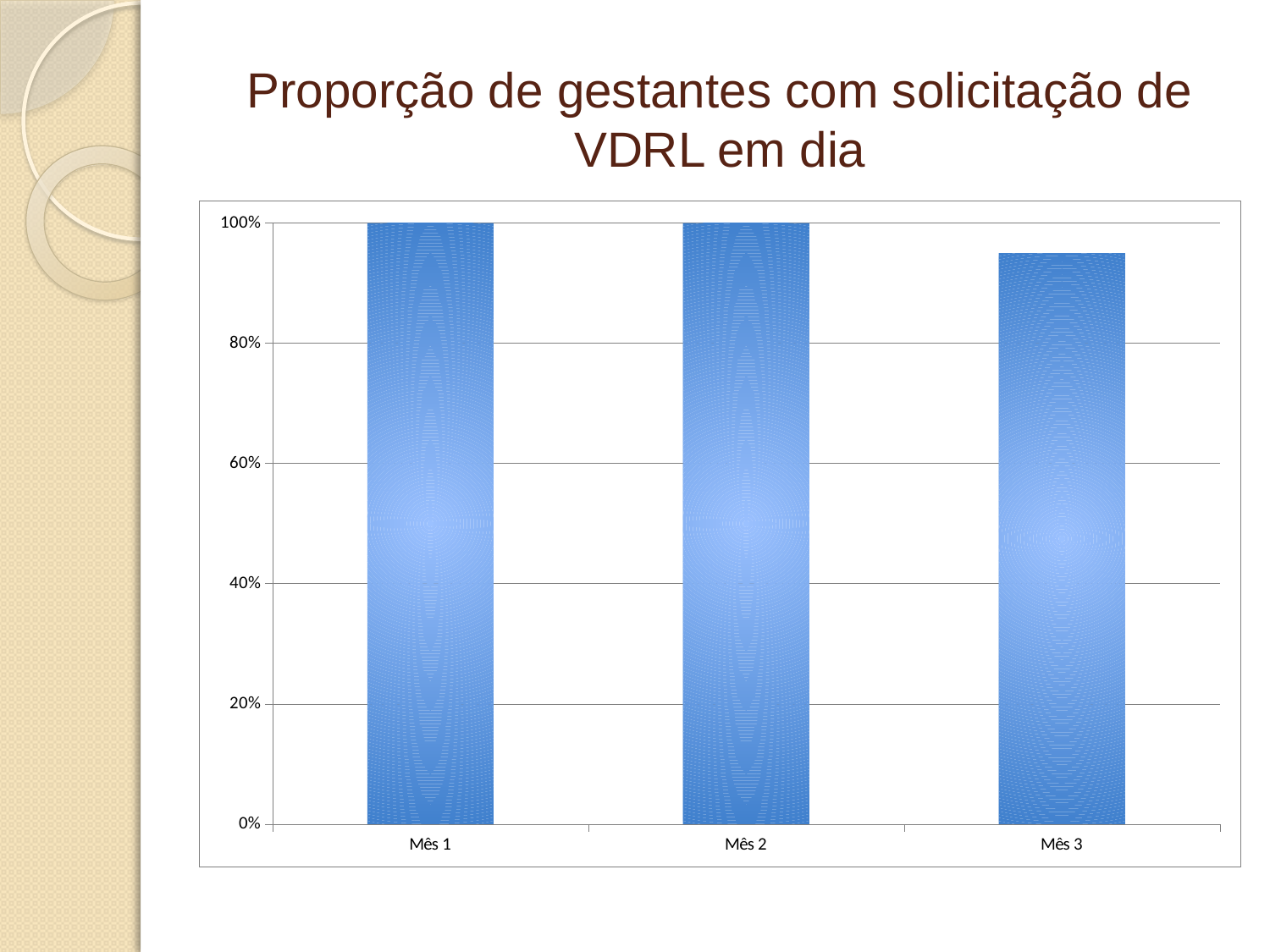
What kind of chart is shown on the slide? Bar chart Which month has the lowest value? Mês 3 Is the value for Mês 3 greater or less than 80%? greater What is the title of the chart on the slide? Proporção de gestantes com solicitação de VDRL em dia Which is larger, the value for Mês 2 or the value for Mês 3? Mês 2 How many categories (months) are shown on the x axis? 3 Which is larger, the value for Mês 1 or the value for Mês 3? Mês 1 What is the value for Mês 1? 100% Is the value for Mês 3 greater or less than 100%? less What is the highest value shown on the y axis? 100% Do the values rise or fall from Mês 1 to Mês 3? fall